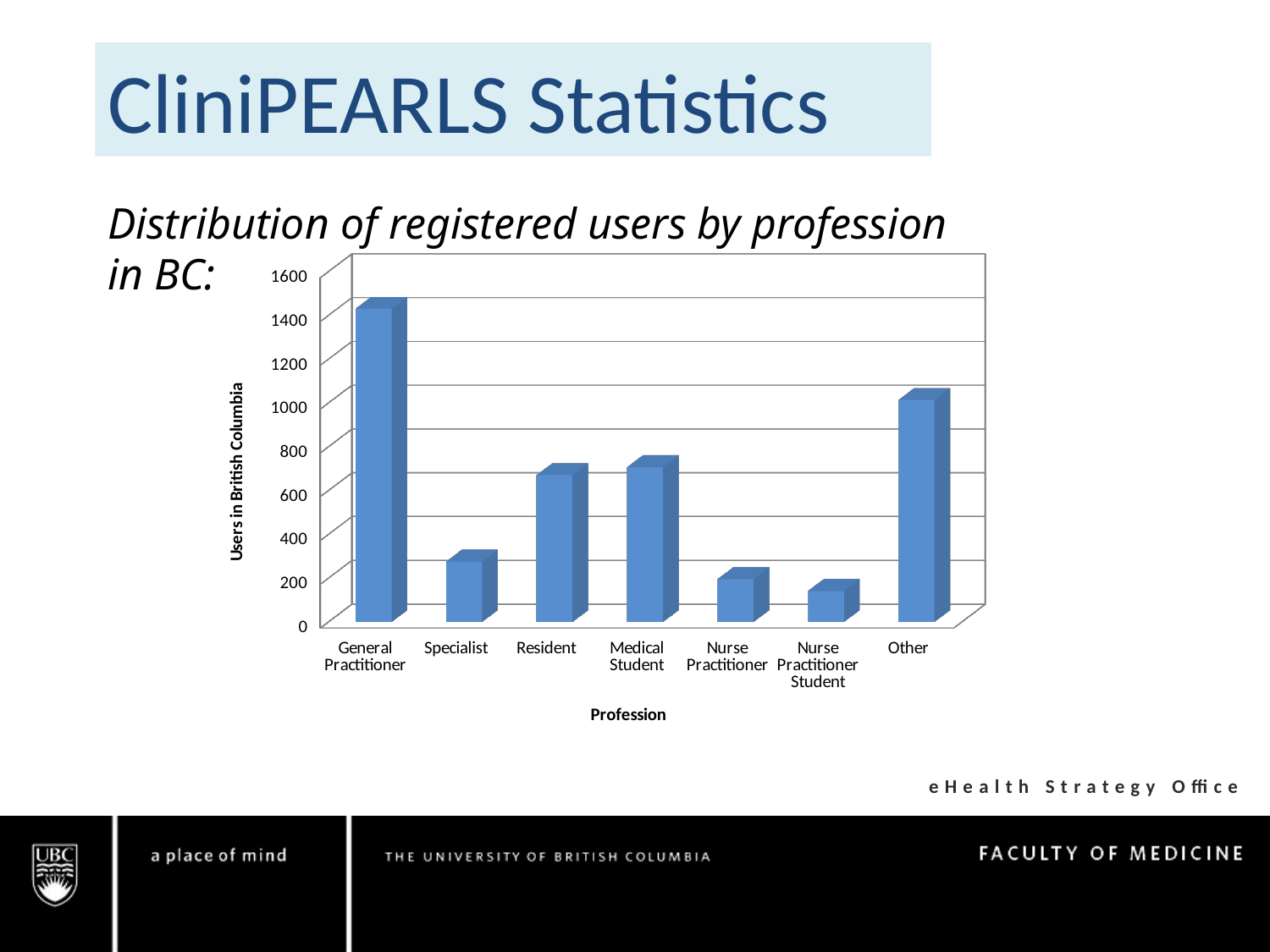
Is the value for Resident greater or less than 400? greater Which profession has the highest number of users in British Columbia? General Practitioner Is the value for General Practitioner greater or less than 1200? greater Is the value for Nurse Practitioner Student greater or less than 200? less Which has more users in British Columbia, Specialist or Nurse Practitioner? Specialist What is the title of the vertical axis of the chart? Users in British Columbia Which profession has the lowest number of users in British Columbia? Nurse Practitioner Student How many professions are shown on the x axis of the chart? 7 Which has more users in British Columbia, General Practitioner or Other? General Practitioner What kind of chart is shown on the slide? bar chart